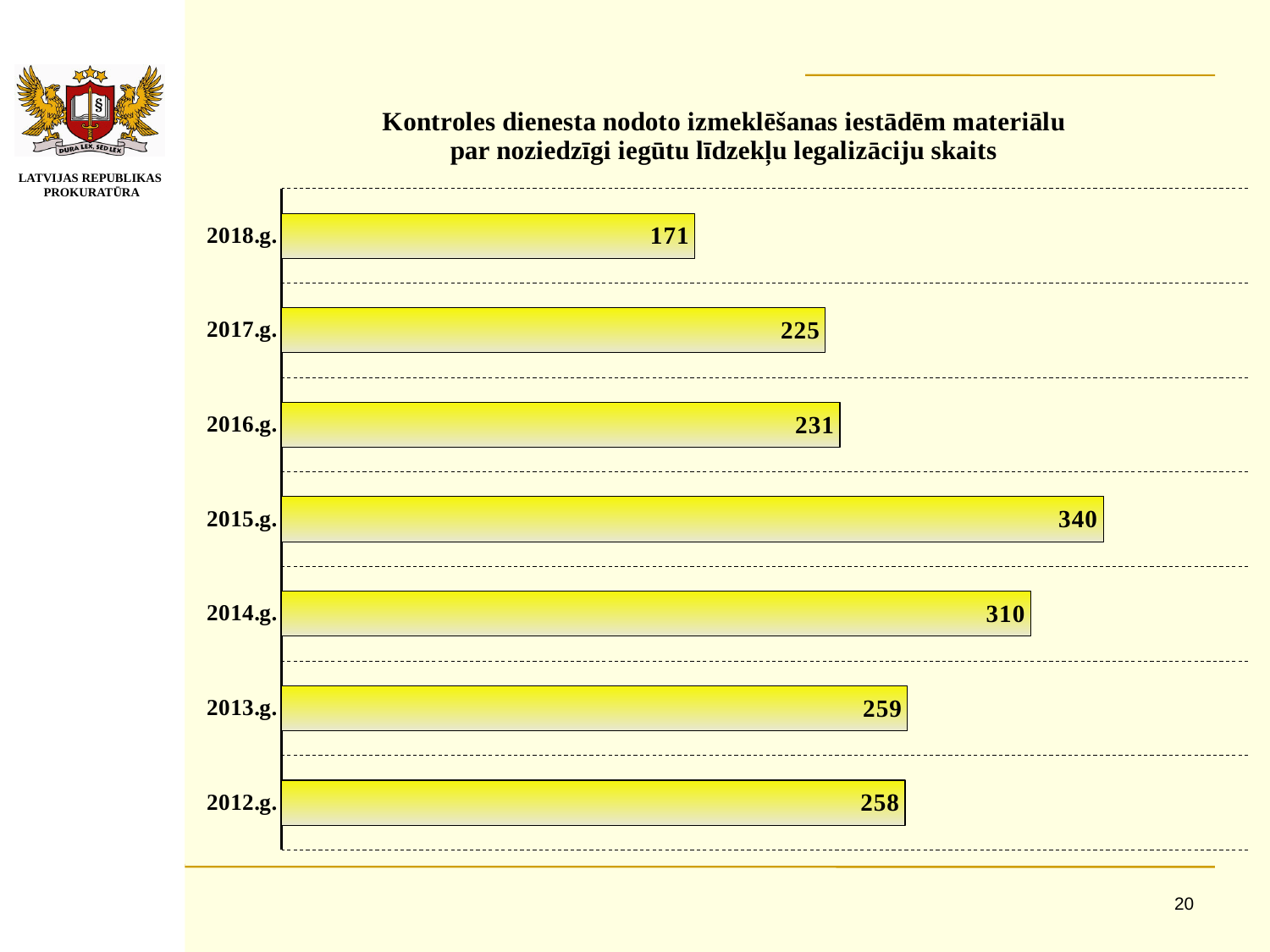
What is the difference between the values for 2017.g. and 2018.g.? 54 Do the values rise or fall from 2015.g. to 2018.g.? fall What is the difference between the values for 2015.g. and 2014.g.? 30 What is the value for 2012.g.? 258 What kind of chart is shown on the slide? bar chart What is the value for 2018.g.? 171 Which is larger, the value for 2014.g. or the value for 2013.g.? 2014.g. What is the value for 2015.g.? 340 Which year has the highest value? 2015.g. Which year has the lowest value? 2018.g. What is the value for 2016.g.? 231 How many years are shown in the chart? 7